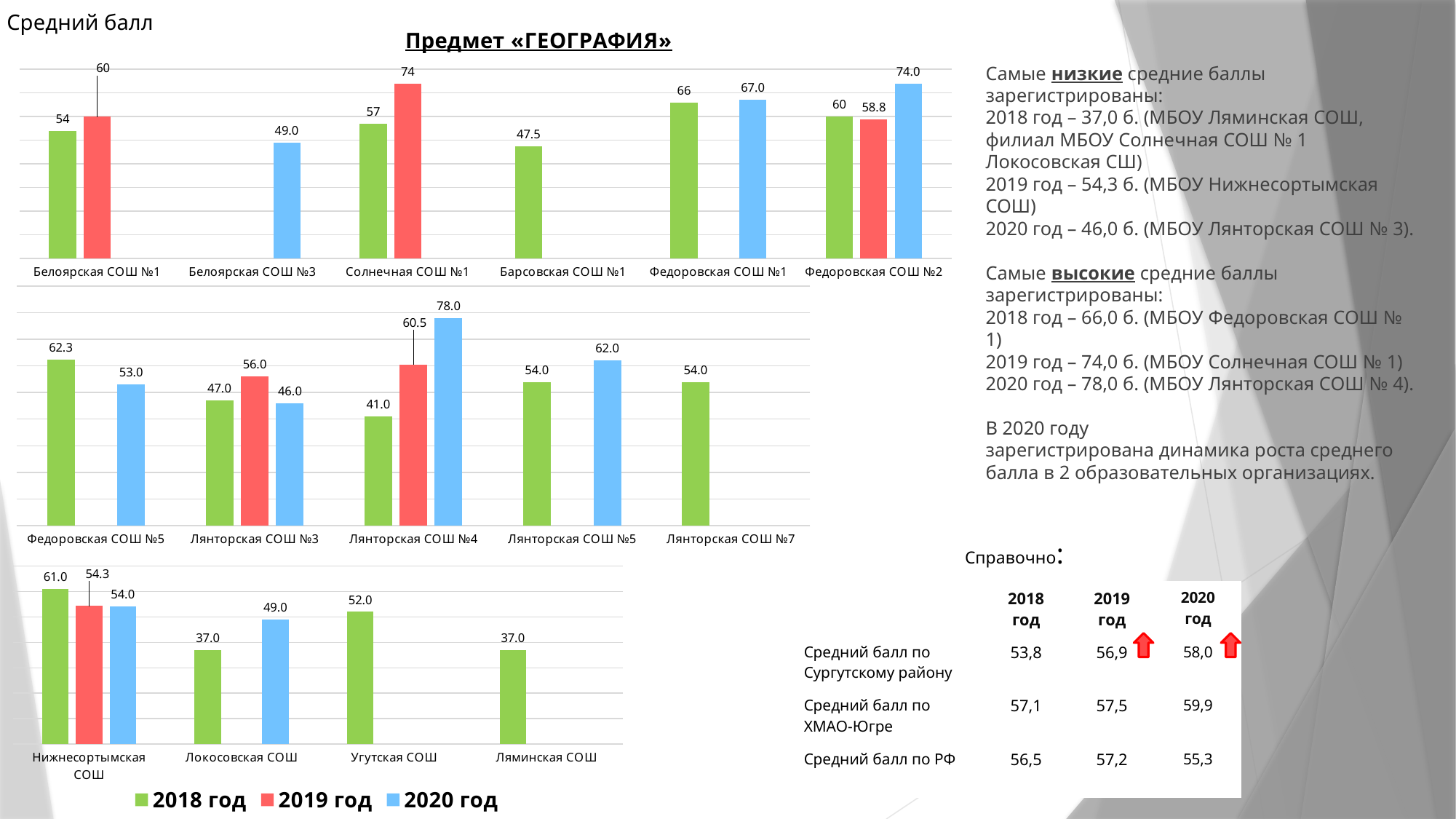
In the bottom chart, what is the 2019 год value for Нижнесортымская СОШ? 54.3 In the top chart, what is the difference between the 2020 год and 2019 год values for Федоровская СОШ №2? 15.2 In the middle chart, do the values for Лянторская СОШ №4 rise or fall from 2018 год to 2020 год? Rise In the top chart, what is the 2019 год value for Солнечная СОШ №1? 74 What is the title shown above the charts? Предмет «ГЕОГРАФИЯ» In the middle chart, which school has the highest 2018 год value? Федоровская СОШ №5 In the bottom chart, which school has the highest 2018 год value? Нижнесортымская СОШ In the middle chart, what is the 2020 год value for Лянторская СОШ №4? 78.0 What type of chart is used on this slide? Bar chart In the middle chart, for Лянторская СОШ №3, which is larger: the 2019 год value or the 2020 год value? 2019 год How many schools are shown on the x axis of the top chart? 6 How many series does the legend at the bottom of the slide list? 3